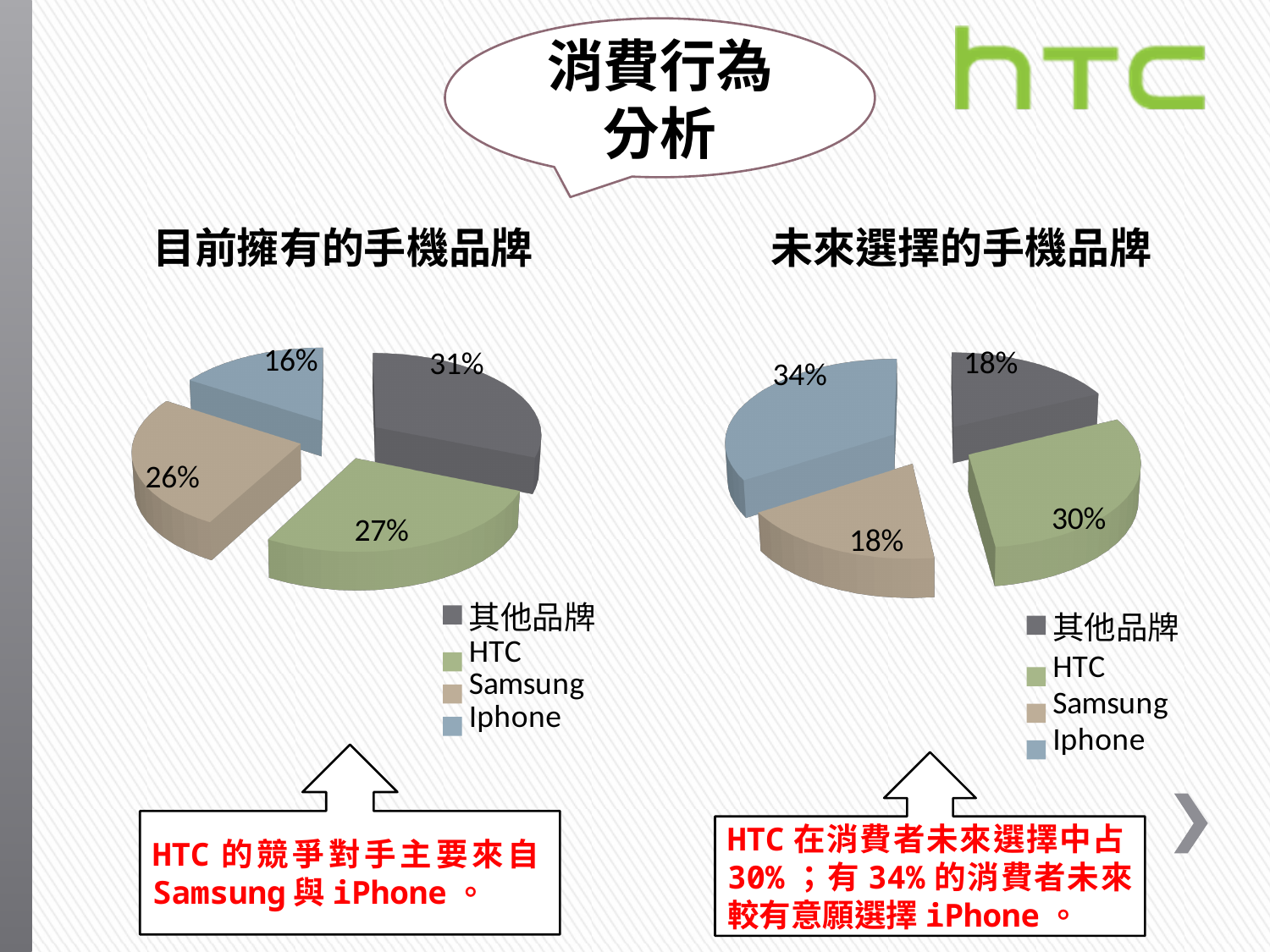
What type of chart is the left chart (目前擁有的手機品牌)? Pie chart How many categories does the legend of the right chart (未來選擇的手機品牌) list? 4 In the left chart (目前擁有的手機品牌), what share does HTC have? 27% In the right chart (未來選擇的手機品牌), which colour represents HTC? Green In the left chart (目前擁有的手機品牌), which is larger, the HTC share or the Samsung share? HTC In the right chart (未來選擇的手機品牌), what share does Samsung have? 18% In the left chart (目前擁有的手機品牌), which category has the smallest slice? Iphone In the left chart (目前擁有的手機品牌), which category has the largest slice? 其他品牌 In the right chart (未來選擇的手機品牌), what share does Iphone have? 34% In the right chart (未來選擇的手機品牌), which category has the largest slice? Iphone In the left chart (目前擁有的手機品牌), what share does Iphone have? 16% In the right chart (未來選擇的手機品牌), what is the difference between the Iphone share and the HTC share? 4%